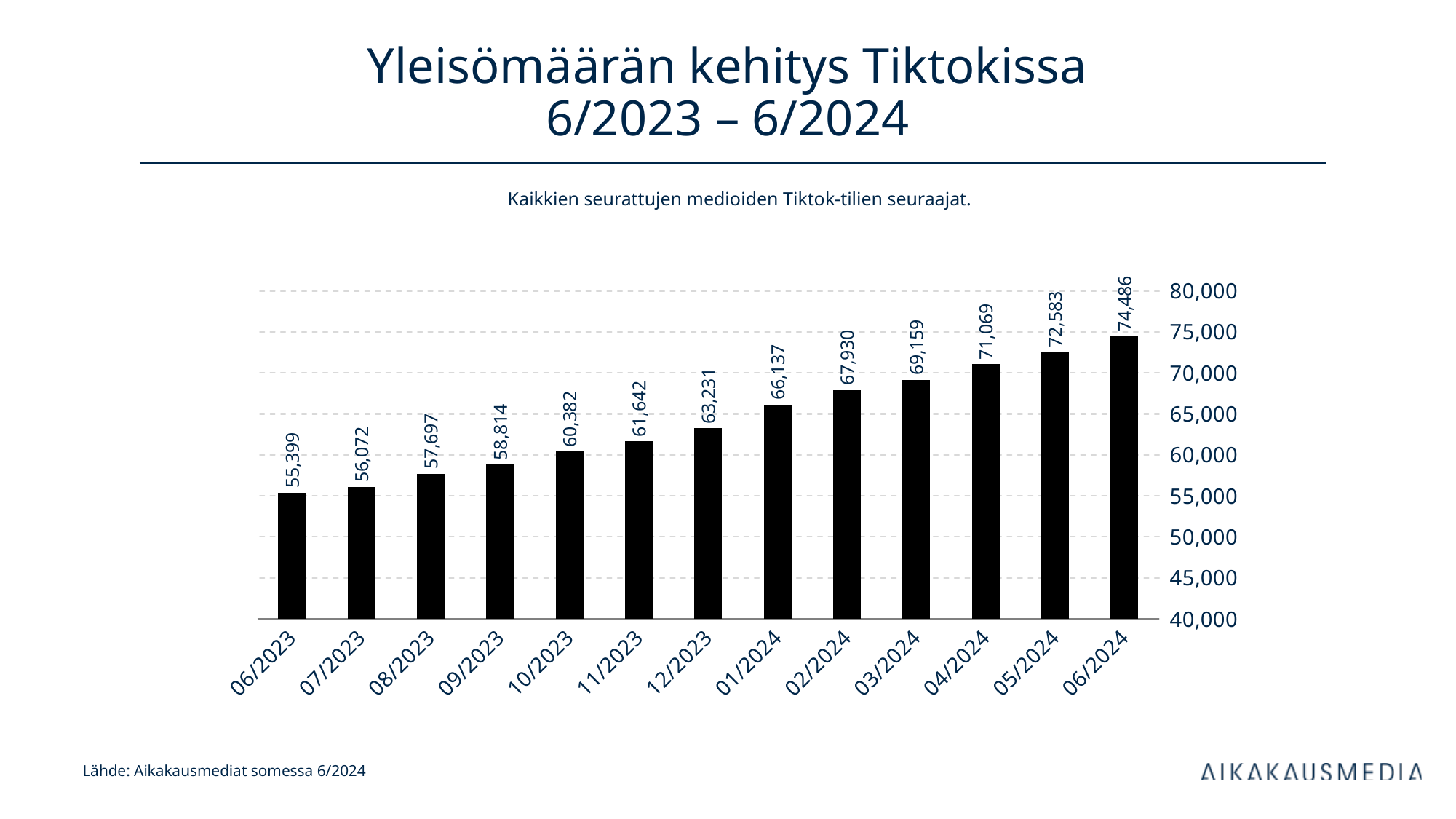
Which is larger, the value for 12/2023 or the value for 02/2024? 02/2024 Which month has the lowest value? 06/2023 What is the value for 06/2024? 74,486 What is the difference between the values for 05/2024 and 04/2024? 1,514 What is the value for 01/2024? 66,137 Do the values rise or fall from 06/2023 to 06/2024? rise What kind of chart is shown on the slide? bar chart Which month has the highest value? 06/2024 How many months are shown on the x axis? 13 What is the difference between the values for 06/2024 and 06/2023? 19,087 What is the value for 06/2023? 55,399 Is the value for 10/2023 greater or less than 60,000? greater